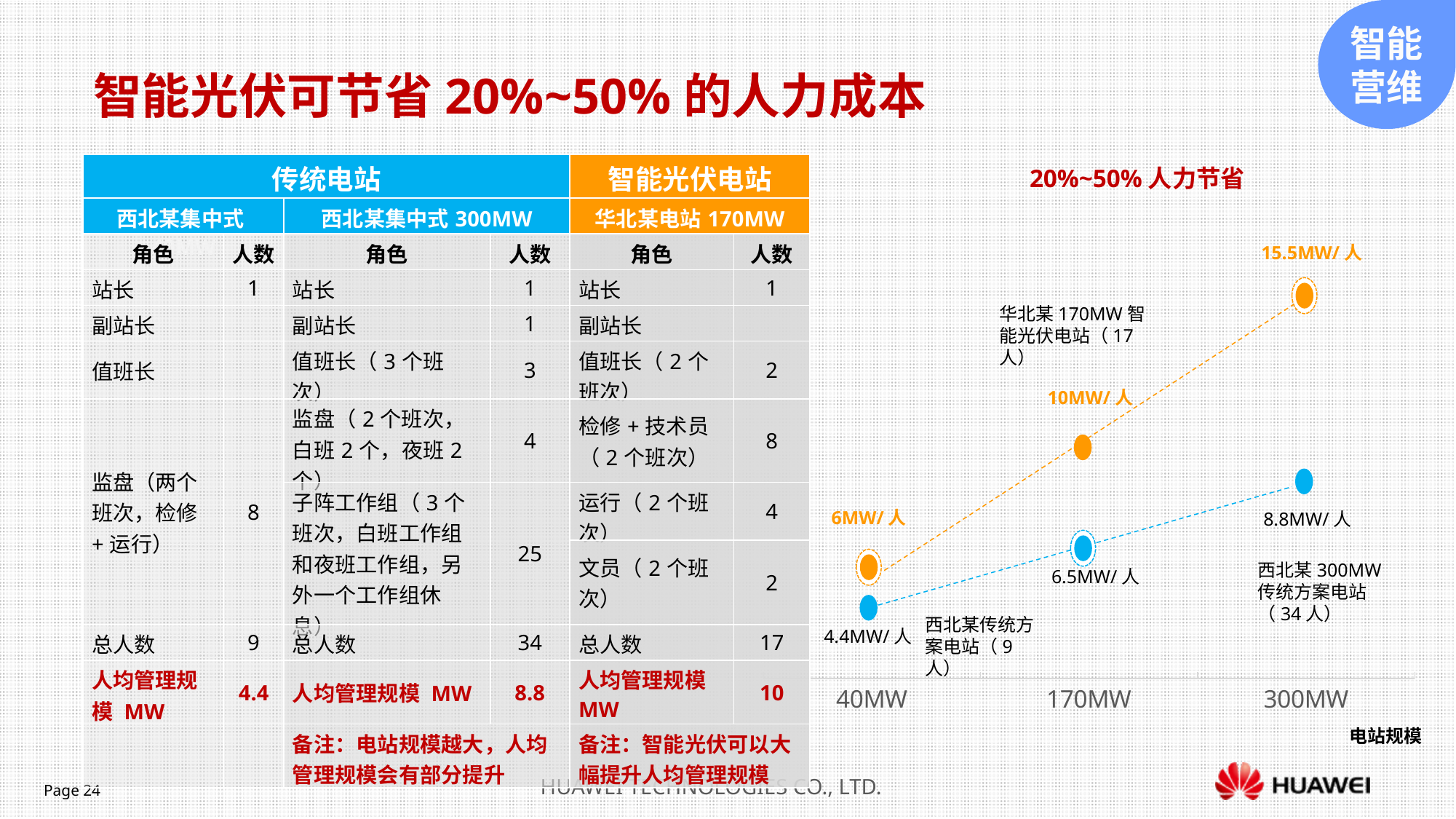
In the chart on the right, what is the difference between the orange and blue values at 300MW? 6.7MW/人 In the chart on the right, how many plant scale categories are shown on the x axis? 3 In the chart on the right, what is the value of the blue series at 170MW? 6.5MW/人 In the chart on the right, do the values rise or fall as plant scale increases from 40MW to 300MW? rise In the chart on the right, what is the value of the orange series at 300MW? 15.5MW/人 In the chart on the right, at which plant scale is the orange series lowest? 40MW In the chart on the right, which is larger at 40MW: the orange series or the blue series? orange series In the chart on the right, what is the value of the orange series at 170MW? 10MW/人 In the chart on the right, at which plant scale is the blue series highest? 300MW In the chart on the right, what is the value of the blue series at 40MW? 4.4MW/人 In the chart on the right, what is the difference between the orange and blue values at 170MW? 3.5MW/人 What kind of chart is shown on the right side of the slide? line chart